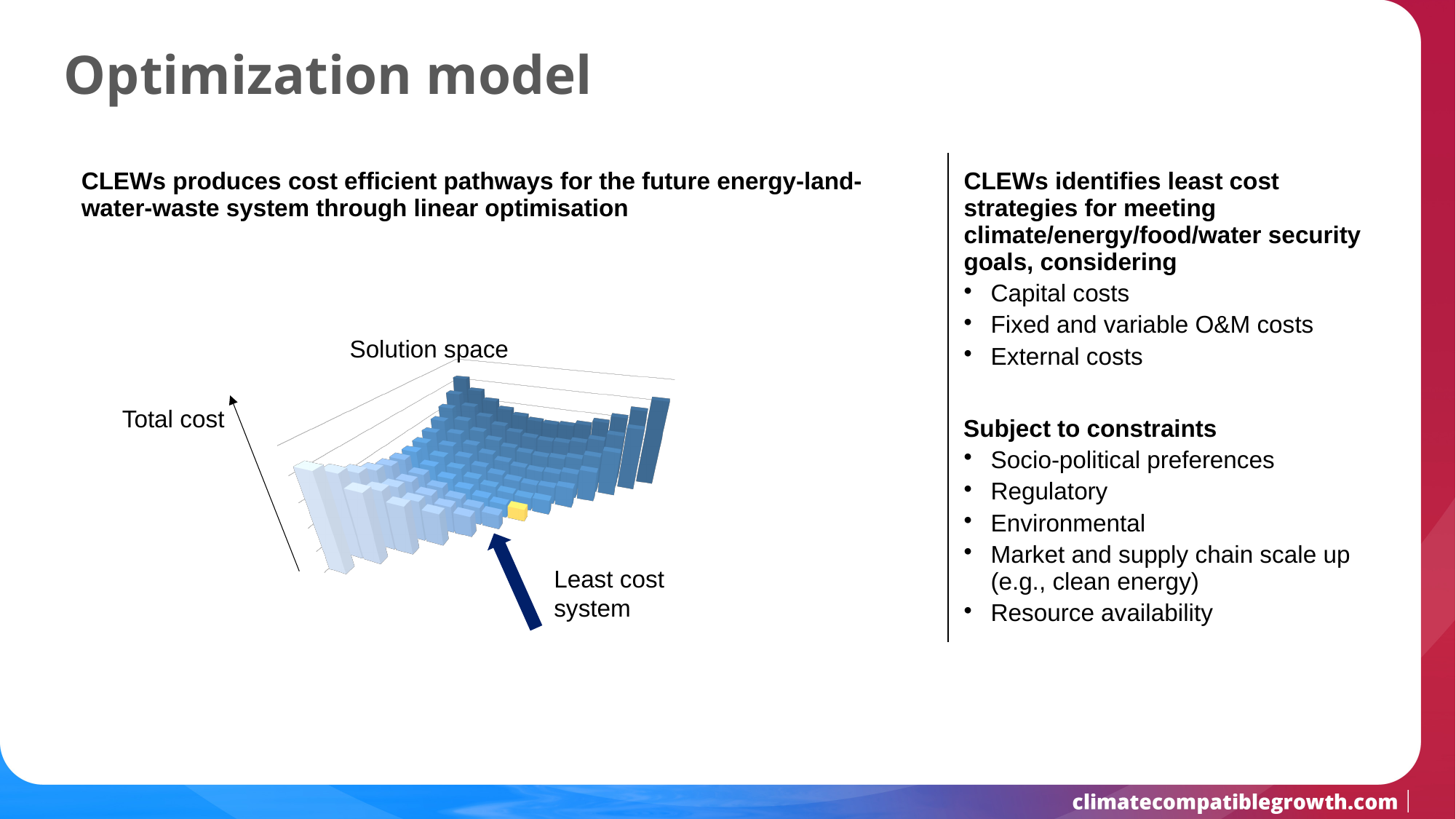
What kind of chart is shown on the slide? 3D bar chart What label is given to the region of bars in the chart? Solution space What does the vertical axis of the chart represent? Total cost What does the yellow bar at the bottom of the chart represent? Least cost system